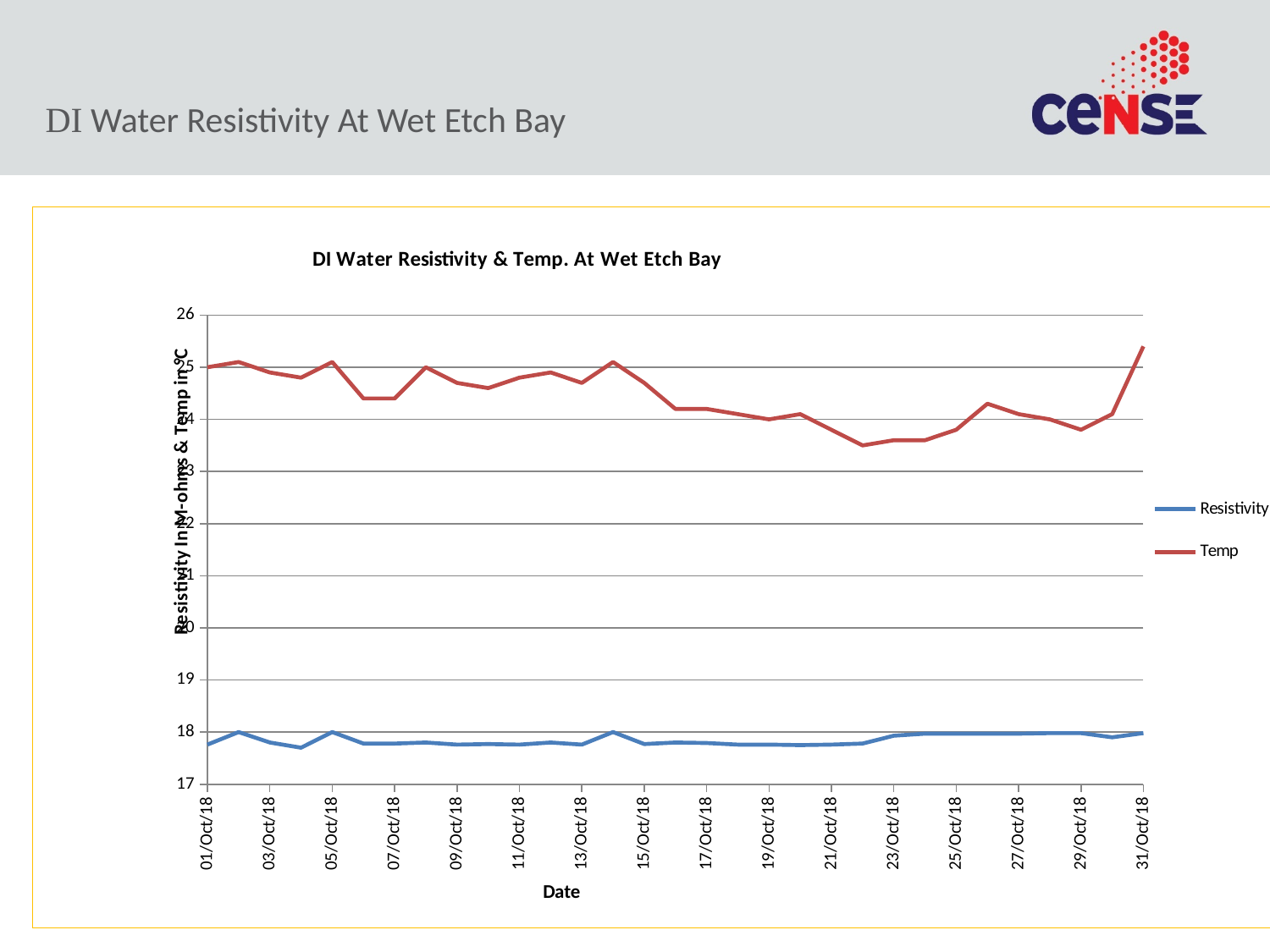
Which series has the higher value on 15/Oct/18, Resistivity or Temp? Temp Which series stays higher across the whole date range? Temp Which colour is used for the Temp series? Red Does the Temp series generally rise or fall between 01/Oct/18 and 22/Oct/18? Fall What kind of chart is shown on the slide? Line chart Is the Resistivity value on 01/Oct/18 greater or less than 19? less How many date labels are shown on the x axis? 16 How many series does the legend list? 2 What is the title of the chart? DI Water Resistivity & Temp. At Wet Etch Bay Is the Temp value on 01/Oct/18 greater or less than 24? greater Is the Temp value on 22/Oct/18 greater or less than 24? less